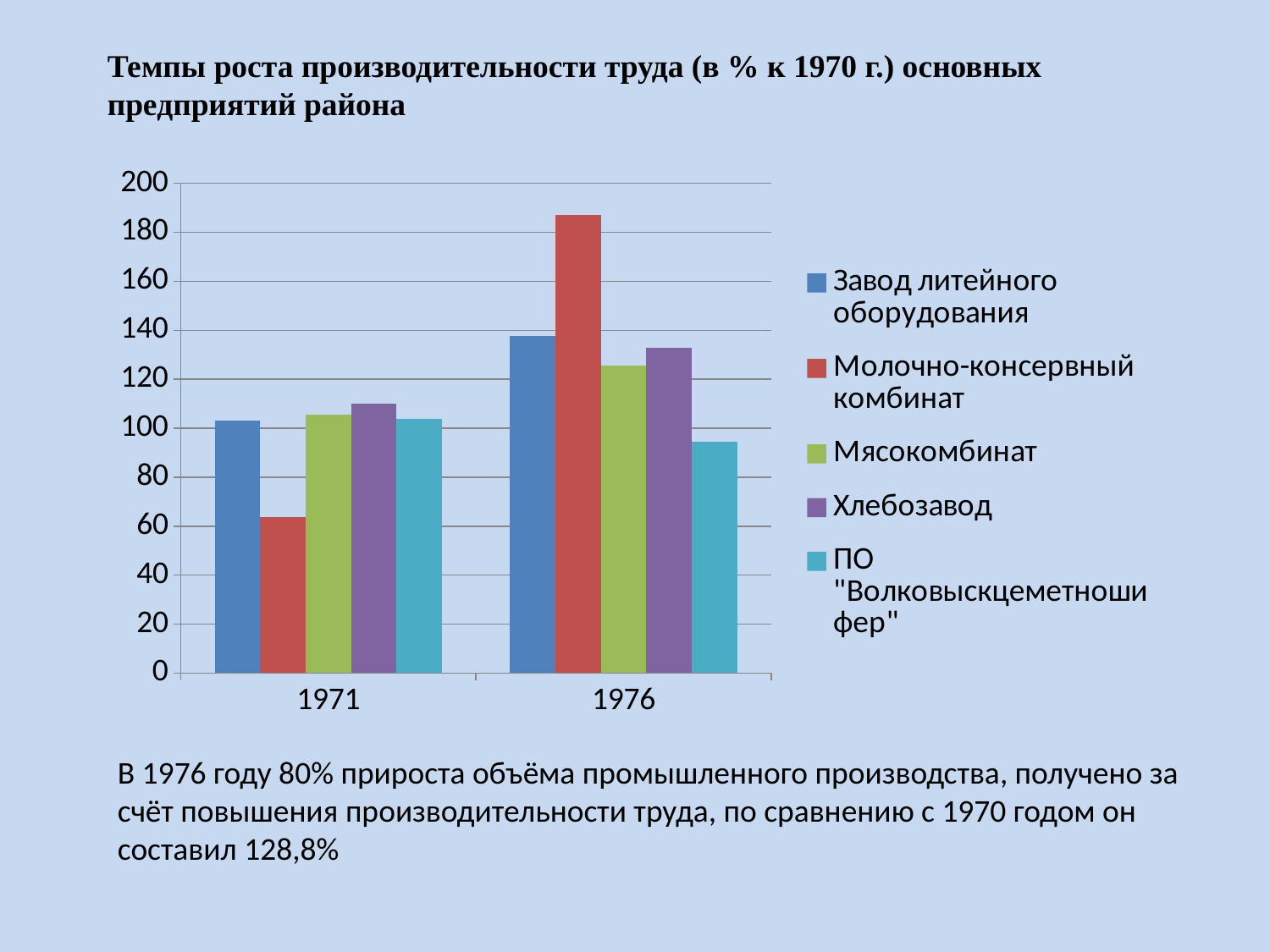
Is the value for ПО "Волковыскцеметношифер" in 1976 greater or less than 100? less Does the value for Молочно-консервный комбинат rise or fall from 1971 to 1976? rise Which enterprise has the lowest value in 1971? Молочно-консервный комбинат Which enterprise has the lowest value in 1976? ПО "Волковыскцеметношифер" How many year categories are shown on the x axis? 2 Is the value for Молочно-консервный комбинат in 1971 greater or less than 80? less Is the value for Молочно-консервный комбинат in 1976 greater or less than 180? greater How many series does the legend list? 5 Which enterprise has the highest value in 1976? Молочно-консервный комбинат Does the value for ПО "Волковыскцеметношифер" rise or fall from 1971 to 1976? fall What kind of chart is shown on the slide? bar chart Which is larger in 1976: the value for Завод литейного оборудования or the value for Мясокомбинат? Завод литейного оборудования